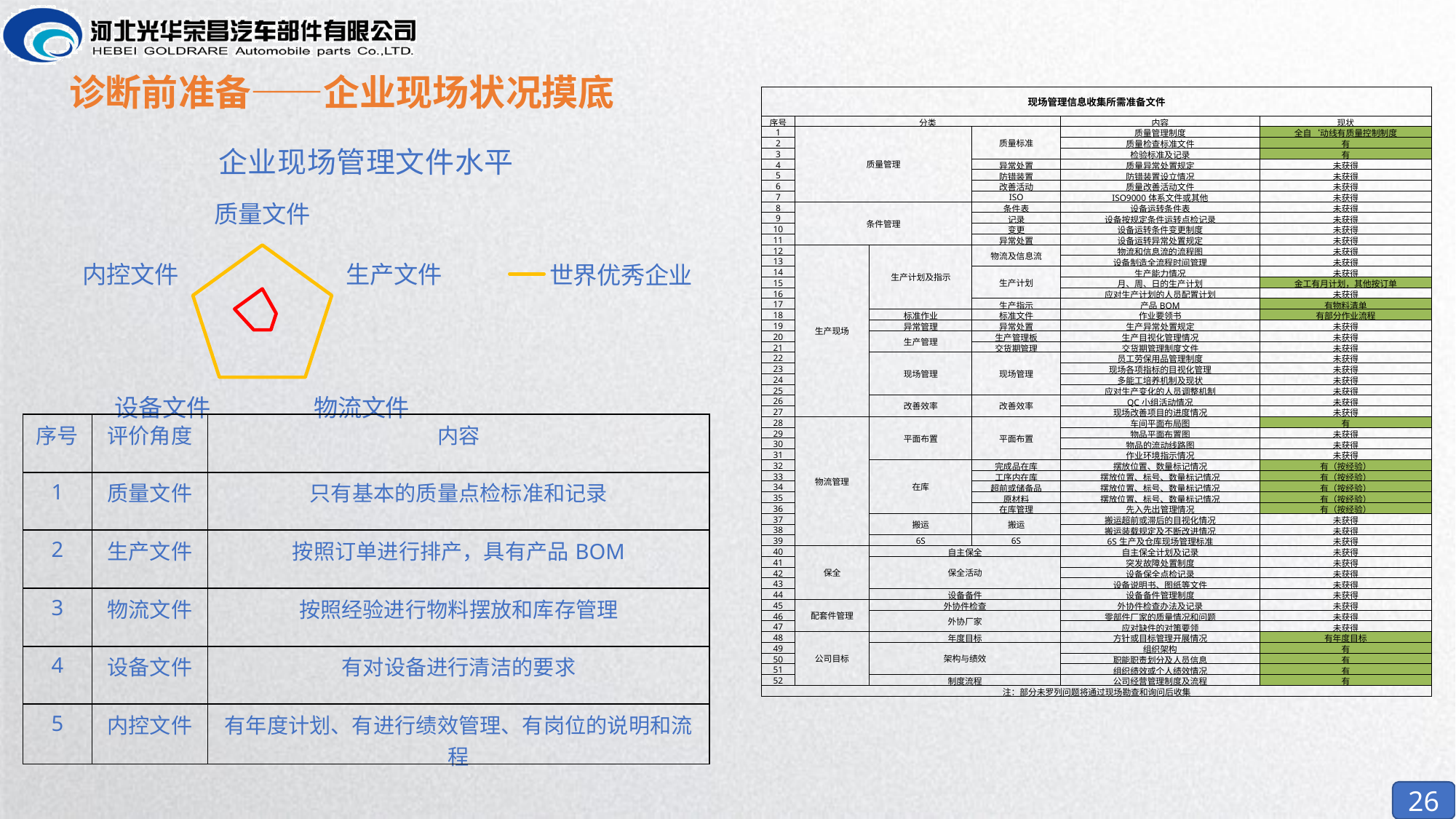
What series name appears in the legend of the radar chart? 世界优秀企业 Which category label sits at the top vertex of the radar chart? 质量文件 Is the red inner shape on the radar chart larger or smaller than the 世界优秀企业 outline? smaller What is the title of the radar chart? 企业现场管理文件水平 How many axes (categories) does the radar chart have? 5 Which category label is on the right side of the radar chart? 生产文件 Which two category labels appear at the bottom of the radar chart? 设备文件 and 物流文件 How many series does the legend of the radar chart list? 1 What kind of chart is shown under the heading 企业现场管理文件水平? Radar chart Which category label is on the left side of the radar chart? 内控文件